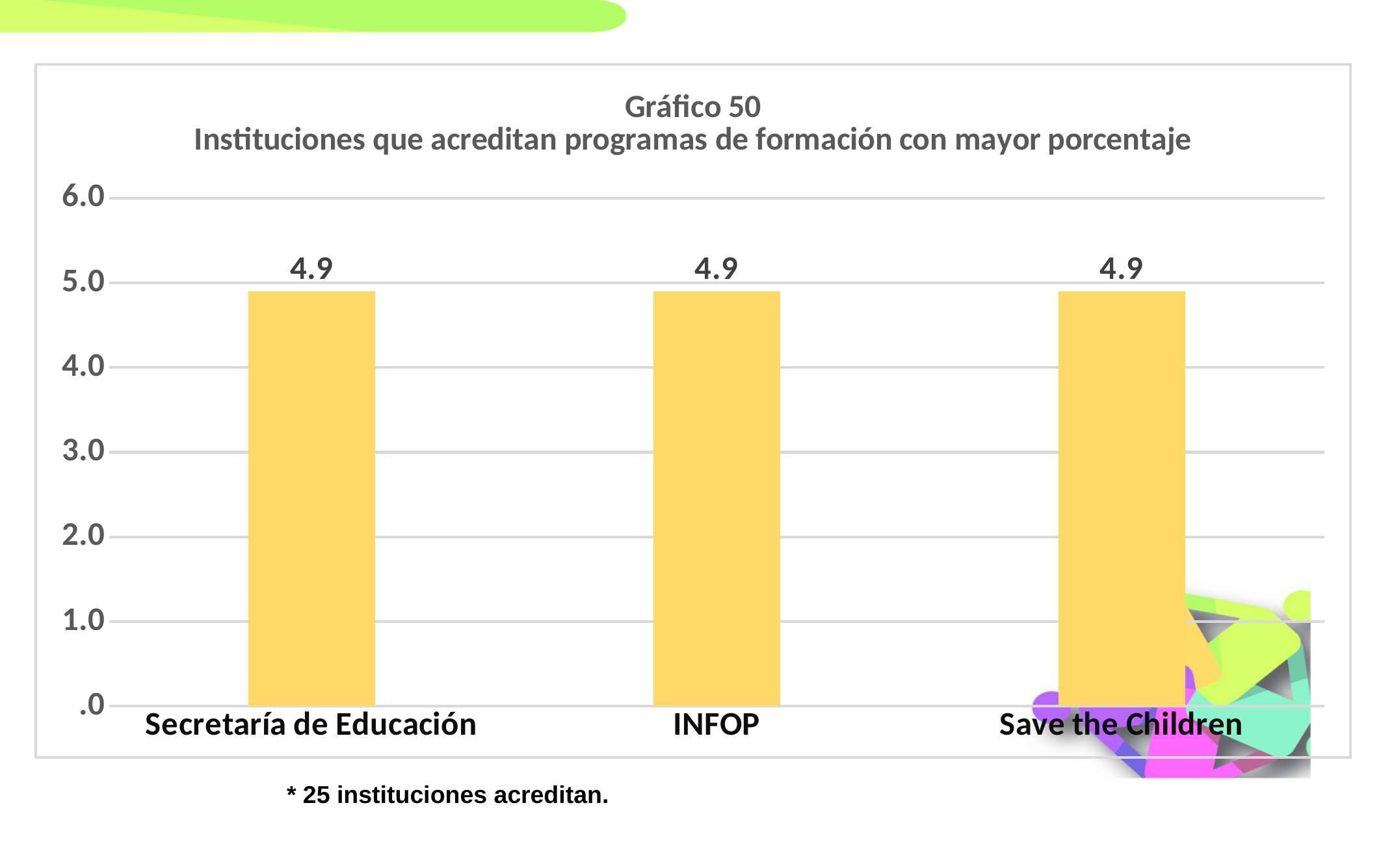
What is the difference between the values for INFOP and Save the Children? 0.0 What is the value for INFOP? 4.9 What kind of chart is shown on the slide? bar chart What is the value for Secretaría de Educación? 4.9 How many categories are shown on the chart? 3 Is the value for INFOP greater or less than 4.0? greater Do the values rise, fall or stay the same across the categories from left to right? stay the same Is the value for Secretaría de Educación greater or less than 5.0? less What is the value for Save the Children? 4.9 What is the highest value shown on the vertical axis? 6.0 What is the title of the chart? Gráfico 50 Instituciones que acreditan programas de formación con mayor porcentaje What colour are the bars in the chart? yellow